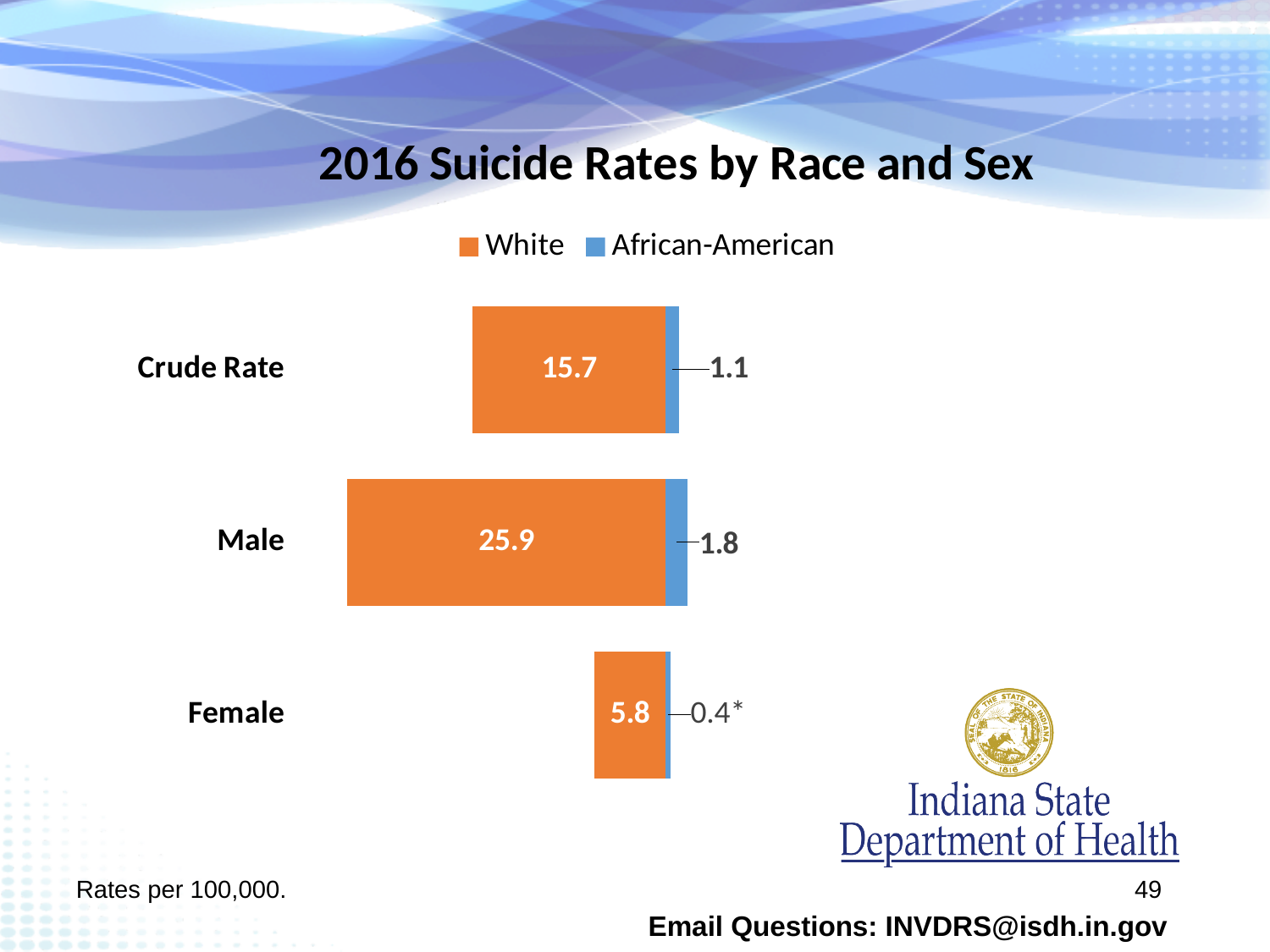
How many categories are shown on the chart? 3 Which category has the highest White suicide rate? Male How many series does the legend list? 2 Which category has the lowest African-American suicide rate? Female What is the difference between the White and African-American rates for Male? 24.1 What is the African-American suicide rate for Crude Rate? 1.1 What is the African-American suicide rate for Male? 1.8 What is the White suicide rate for Male? 25.9 What is the African-American suicide rate for Female, as labelled on the chart? 0.4* Which is larger, the White rate for Crude Rate or the White rate for Female? White rate for Crude Rate What kind of chart is shown on the slide? Bar chart What is the White suicide rate for Female? 5.8